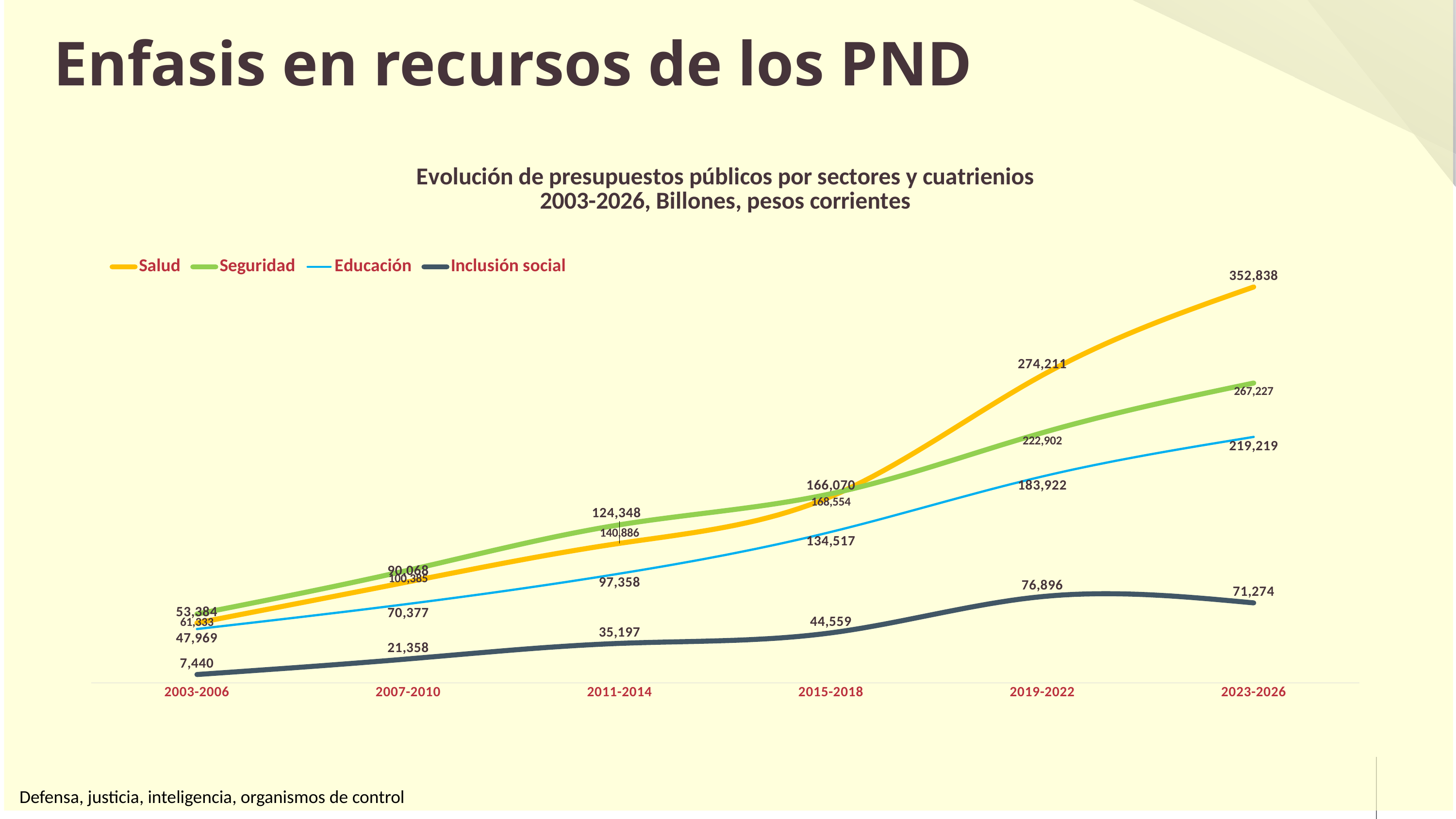
What is the value for Educación in 2015-2018? 134,517 What is the value for Salud in 2023-2026? 352,838 What kind of chart is shown on the slide? Line chart What is the difference between Salud and Seguridad in 2023-2026? 85,611 Which series has the highest value in 2023-2026? Salud How many periods (cuatrienios) are shown on the x axis? 6 Does the value for Inclusión social rise or fall from 2019-2022 to 2023-2026? Fall Which series has the lowest value in 2023-2026? Inclusión social How many series does the legend list? 4 What is the value for Inclusión social in 2003-2006? 7,440 What is the value for Educación in 2023-2026? 219,219 Which is larger in 2019-2022, Seguridad or Educación? Seguridad